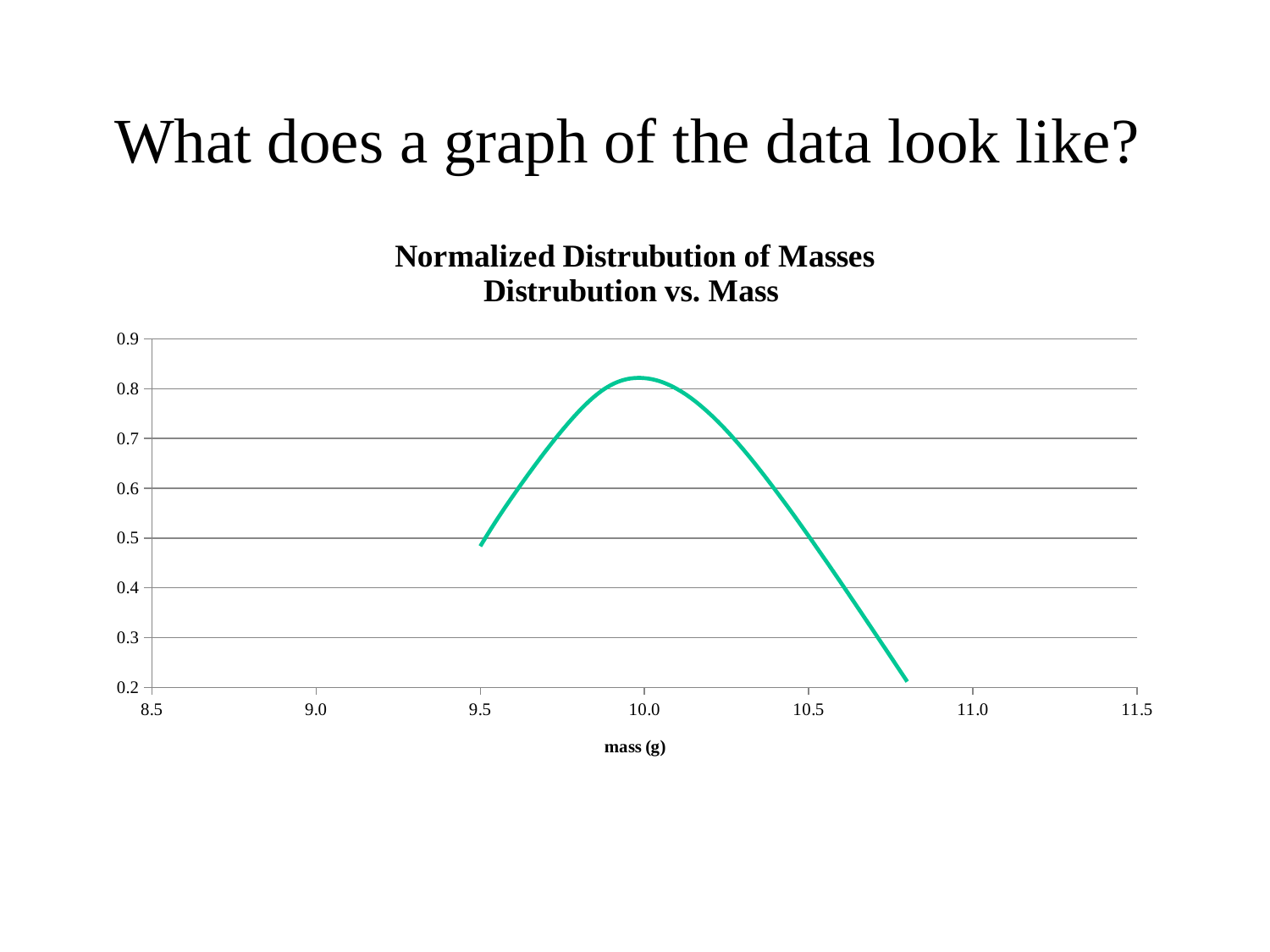
Is the value of the curve at a mass of 9.5 g greater or less than 0.6? less Is the value of the curve at a mass of 10.5 g greater or less than 0.4? greater What is the label on the x axis of the chart? mass (g) Near which x-axis tick does the curve reach its highest value? 10.0 What is the title of the chart? Normalized Distrubution of Masses Distrubution vs. Mass Is the value of the curve at a mass of 10.5 g greater or less than 0.6? less Which is larger, the value of the curve at 9.5 g or at 10.0 g? 10.0 g What kind of chart is shown on the slide? line chart Does the curve rise or fall as mass increases from 10.0 g to 10.5 g? fall Does the curve rise or fall as mass increases from 9.5 g to 10.0 g? rise